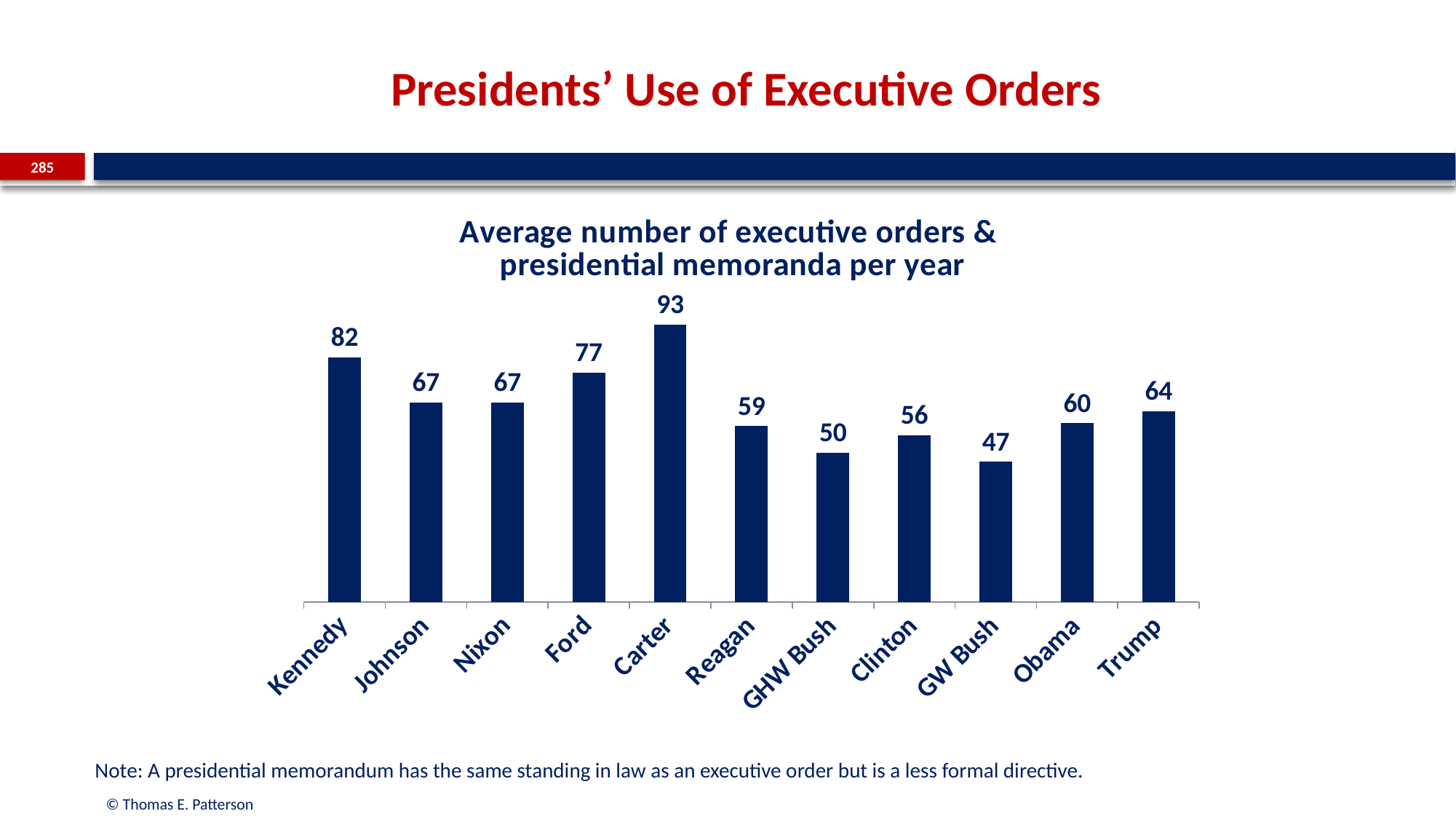
Which president has the lowest average number of executive orders & presidential memoranda per year? GW Bush Which has a larger value, Ford or Trump? Ford What is the average number of executive orders & presidential memoranda per year for Carter? 93 Which president has the highest average number of executive orders & presidential memoranda per year? Carter What is the title of the chart? Average number of executive orders & presidential memoranda per year What kind of chart is shown on the slide? Bar chart Which has a larger value, Clinton or GHW Bush? Clinton How many presidents are shown on the chart? 11 What is the difference between the values for Kennedy and Reagan? 23 What is the value shown for GW Bush? 47 What is the value shown for Obama? 60 What is the difference between the values for Carter and GW Bush? 46